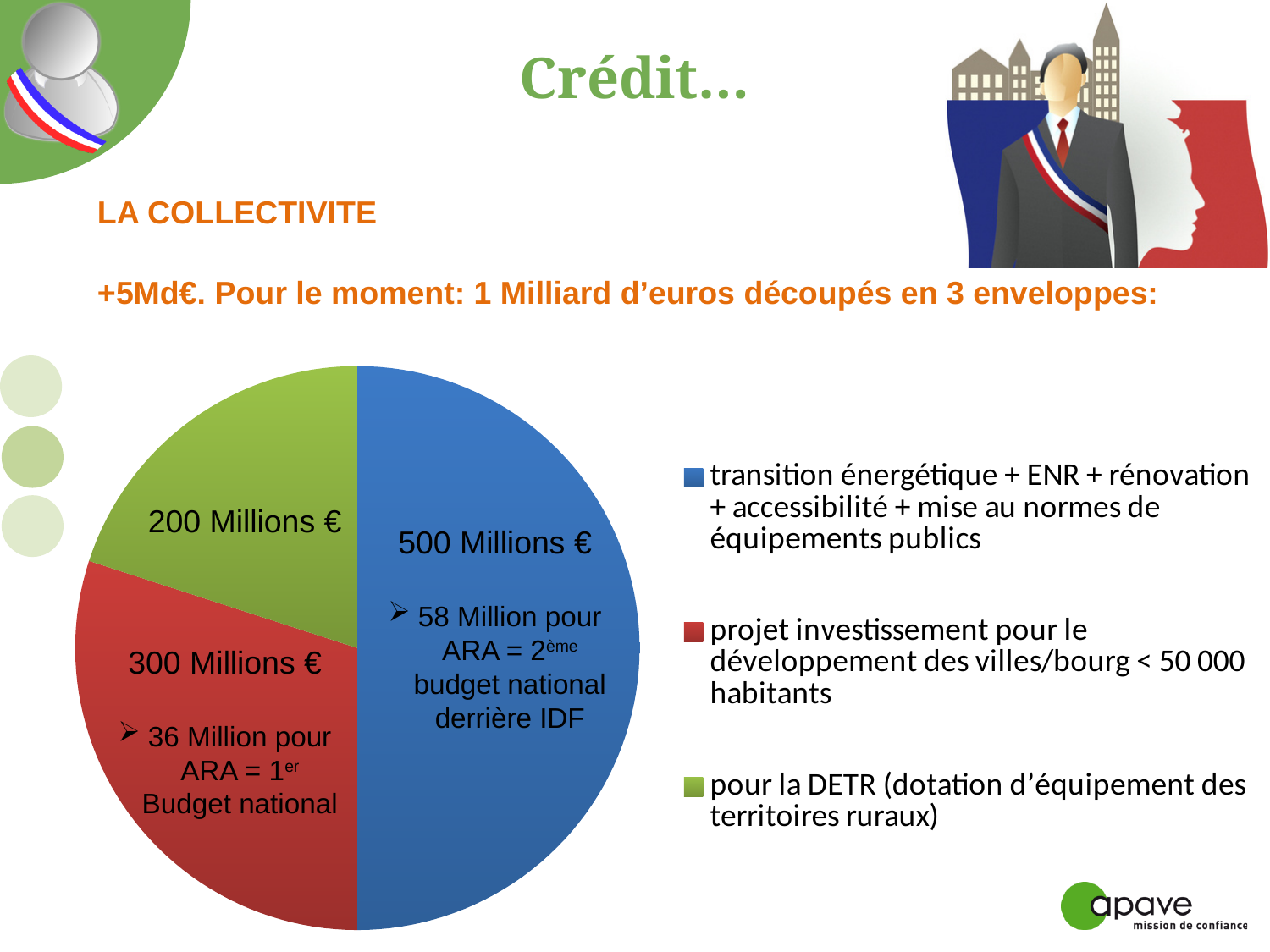
Which slice of the pie chart is the largest? transition énergétique + ENR + rénovation + accessibilité + mise au normes de équipements publics How many slices does the pie chart have? 3 What is the difference between the 'transition énergétique' slice and the 'projet investissement' slice? 200 Millions € What value is shown for the 'pour la DETR (dotation d'équipement des territoires ruraux)' slice? 200 Millions € What colour is the slice for 'pour la DETR (dotation d'équipement des territoires ruraux)'? green Which is larger: the 'pour la DETR' slice or the 'projet investissement' slice? projet investissement What kind of chart is shown on the slide? pie chart How many entries does the legend of the pie chart list? 3 What value is shown for the 'transition énergétique + ENR + rénovation' slice? 500 Millions € What value is shown for the 'projet investissement pour le développement des villes/bourg < 50 000 habitants' slice? 300 Millions € Which slice of the pie chart is the smallest? pour la DETR (dotation d'équipement des territoires ruraux) What share of the pie does the 500 Millions € slice represent? 50%